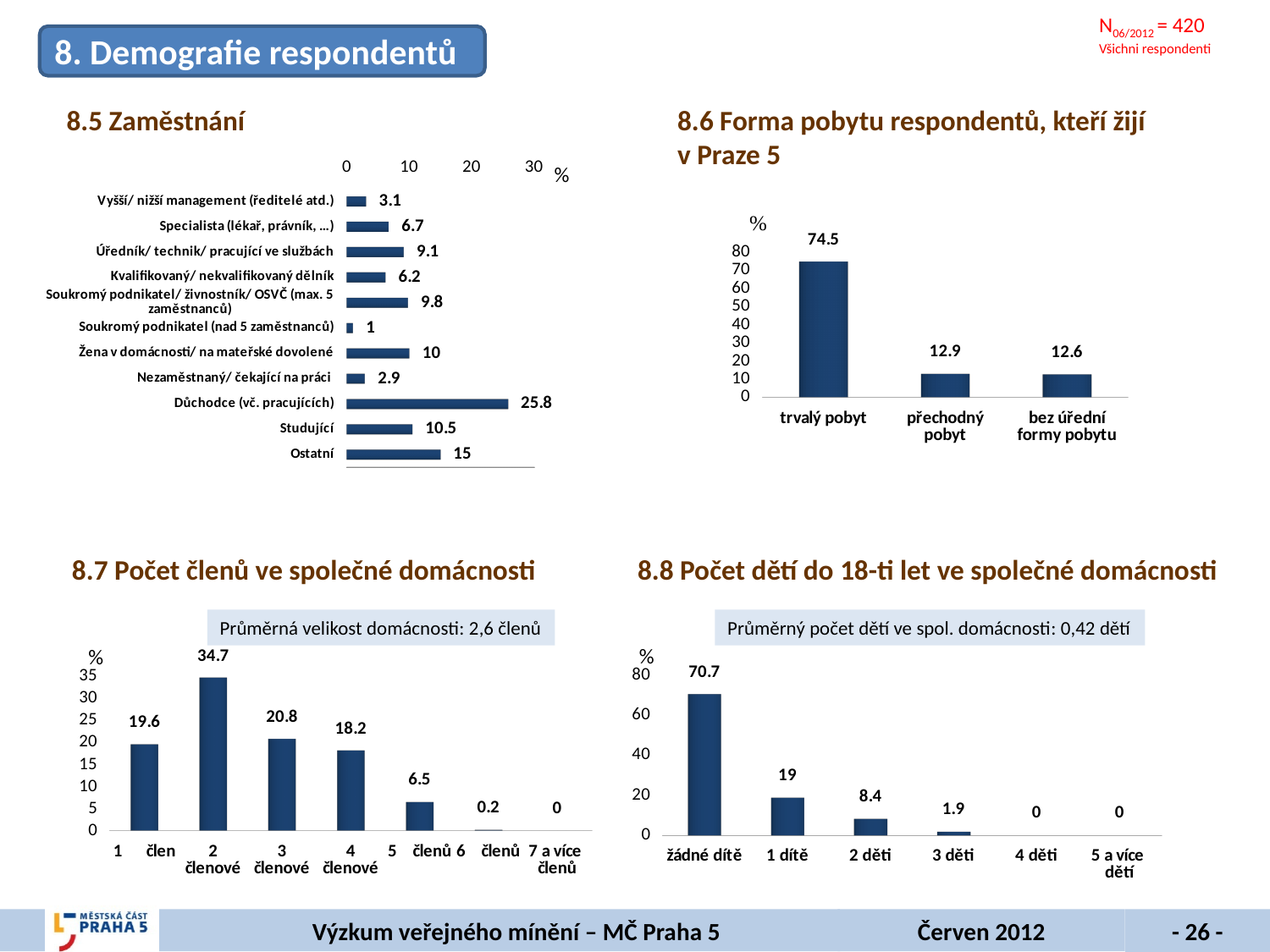
What average number of children is stated in the text box of the '8.8 Počet dětí do 18-ti let ve společné domácnosti' chart? 0,42 dětí In the '8.8 Počet dětí do 18-ti let ve společné domácnosti' chart, what is the value for '1 dítě'? 19 In the '8.5 Zaměstnání' chart, which category has the lowest value? Soukromý podnikatel (nad 5 zaměstnanců) In the '8.7 Počet členů ve společné domácnosti' chart, which is larger: '3 členové' or '4 členové'? 3 členové In the '8.8 Počet dětí do 18-ti let ve společné domácnosti' chart, do the values rise or fall from 'žádné dítě' to '5 a více dětí'? Fall In the '8.5 Zaměstnání' chart, what is the value for 'Důchodce (vč. pracujících)'? 25.8 In the '8.6 Forma pobytu respondentů, kteří žijí v Praze 5' chart, what is the value for 'trvalý pobyt'? 74.5 In the '8.7 Počet členů ve společné domácnosti' chart, what is the value for '5 členů'? 6.5 What kind of chart is the '8.5 Zaměstnání' chart? Bar chart In the '8.7 Počet členů ve společné domácnosti' chart, which category has the highest value? 2 členové In the '8.6 Forma pobytu respondentů, kteří žijí v Praze 5' chart, what is the difference between 'přechodný pobyt' and 'bez úřední formy pobytu'? 0.3 How many categories are shown in the '8.5 Zaměstnání' chart? 11